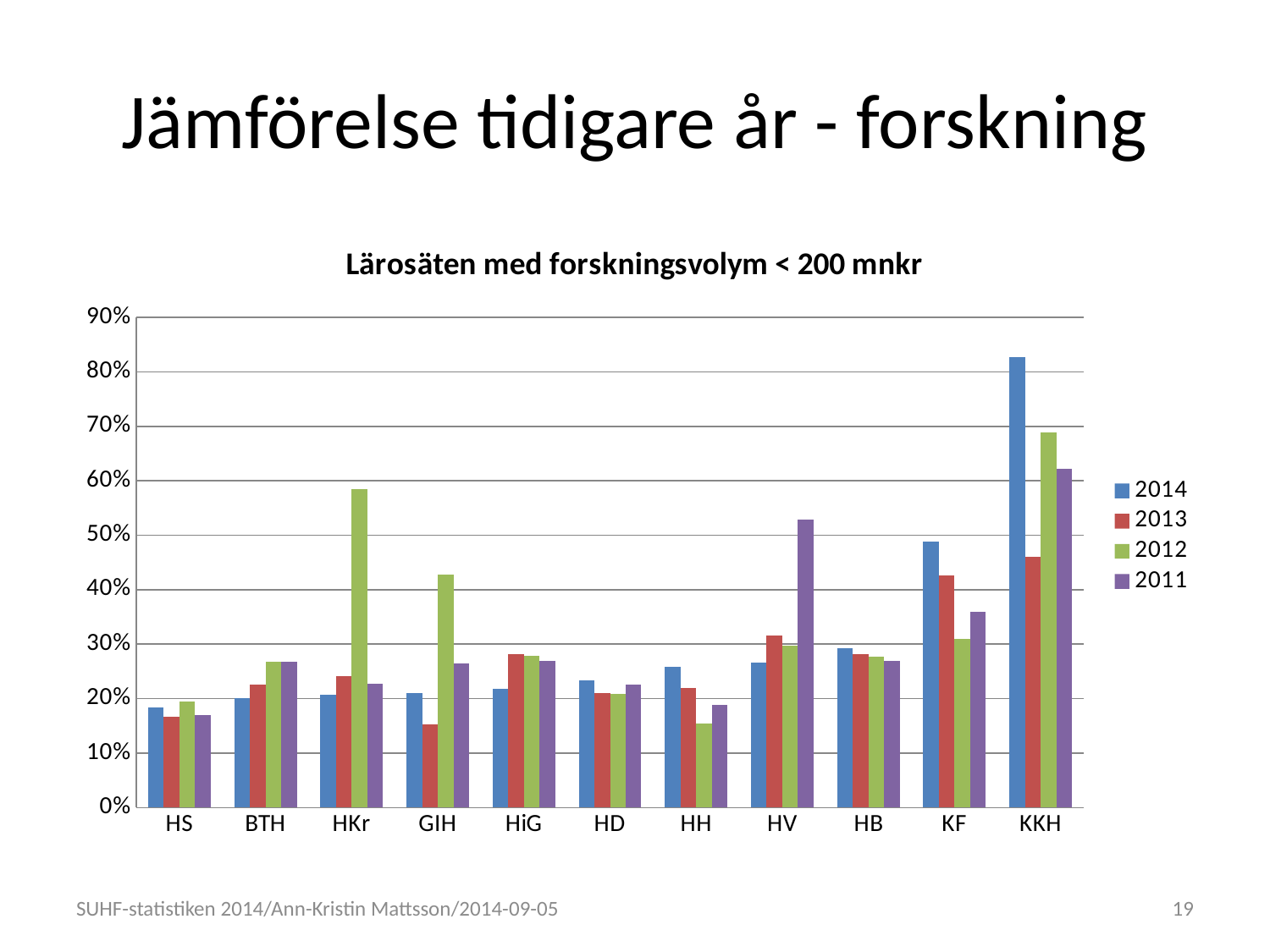
Is the 2014 value for KKH greater or less than 80%? greater Which years are listed in the chart's legend? 2014, 2013, 2012, 2011 Is the 2012 value for HKr greater or less than 50%? greater Is the 2013 value for GIH greater or less than 20%? less For KF, which year has the larger value, 2014 or 2013? 2014 Which institution has the highest value for 2014? KKH How many series does the chart's legend list? 4 What is the title of the chart? Lärosäten med forskningsvolym < 200 mnkr How many institutions (categories) are shown on the x axis of the chart? 11 Which institution has the lowest value for 2012? HH For HV, which year has the larger value, 2011 or 2014? 2011 What kind of chart is shown on the slide? bar chart